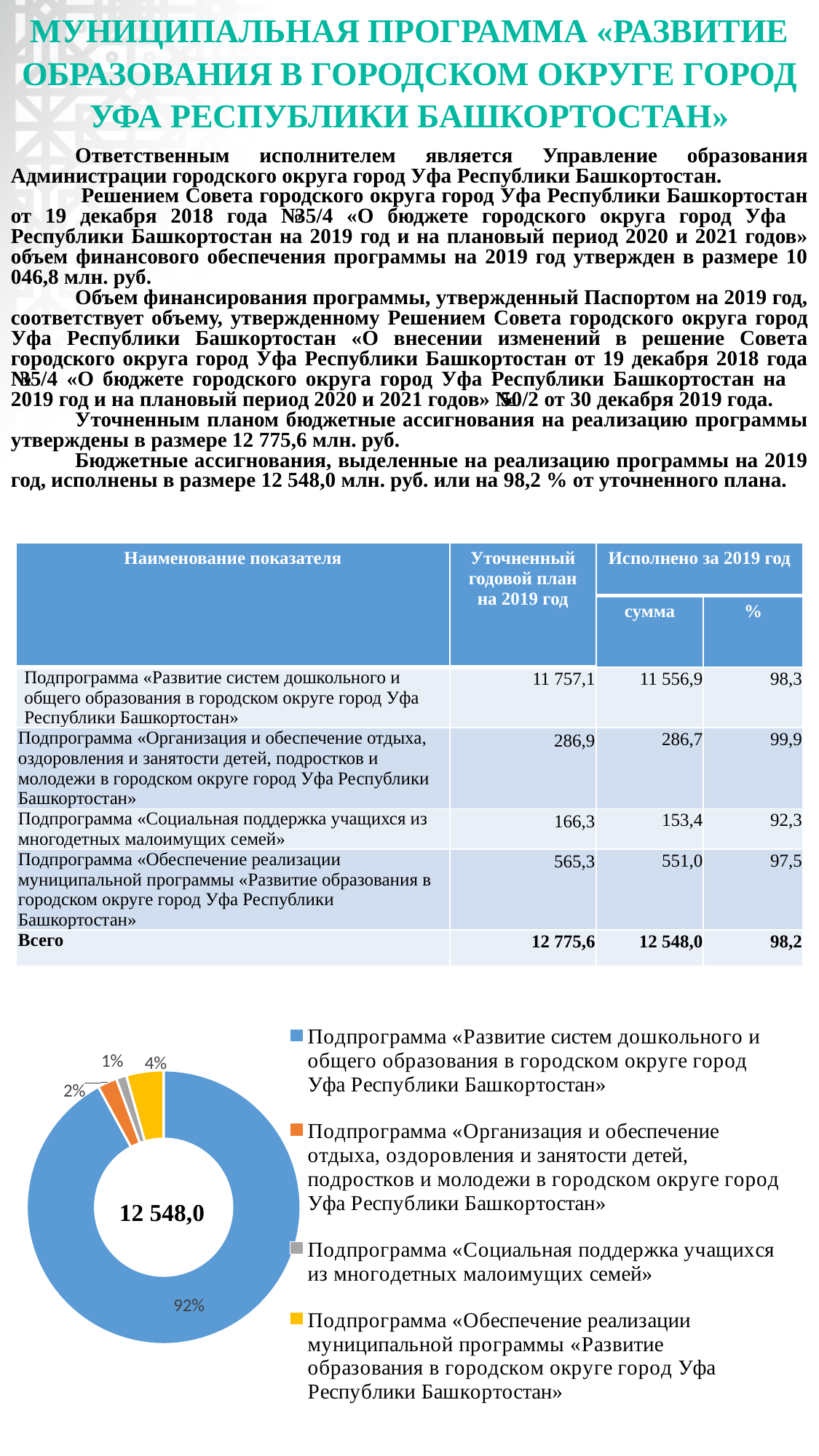
What share of the doughnut chart does the subprogram «Обеспечение реализации муниципальной программы «Развитие образования в городском округе город Уфа Республики Башкортостан»» take? 4% Which subprogram has the largest slice in the doughnut chart? Подпрограмма «Развитие систем дошкольного и общего образования в городском округе город Уфа Республики Башкортостан» What share of the doughnut chart does the subprogram «Организация и обеспечение отдыха, оздоровления и занятости детей, подростков и молодежи в городском округе город Уфа Республики Башкортостан» take? 2% What share of the doughnut chart does the subprogram «Развитие систем дошкольного и общего образования в городском округе город Уфа Республики Башкортостан» take? 92% What value is printed in the centre of the doughnut chart? 12 548,0 What kind of chart is shown at the bottom of the slide? Doughnut (pie) chart How many entries does the legend of the doughnut chart list? 4 In the doughnut chart, which slice is larger: the one for «Организация и обеспечение отдыха...» or the one for «Обеспечение реализации муниципальной программы...»? Подпрограмма «Обеспечение реализации муниципальной программы...» By how many percentage points does the largest slice of the doughnut chart exceed the 4% slice? 88 percentage points How many slices does the doughnut chart have? 4 Which subprogram has the smallest slice in the doughnut chart? Подпрограмма «Социальная поддержка учащихся из многодетных малоимущих семей»